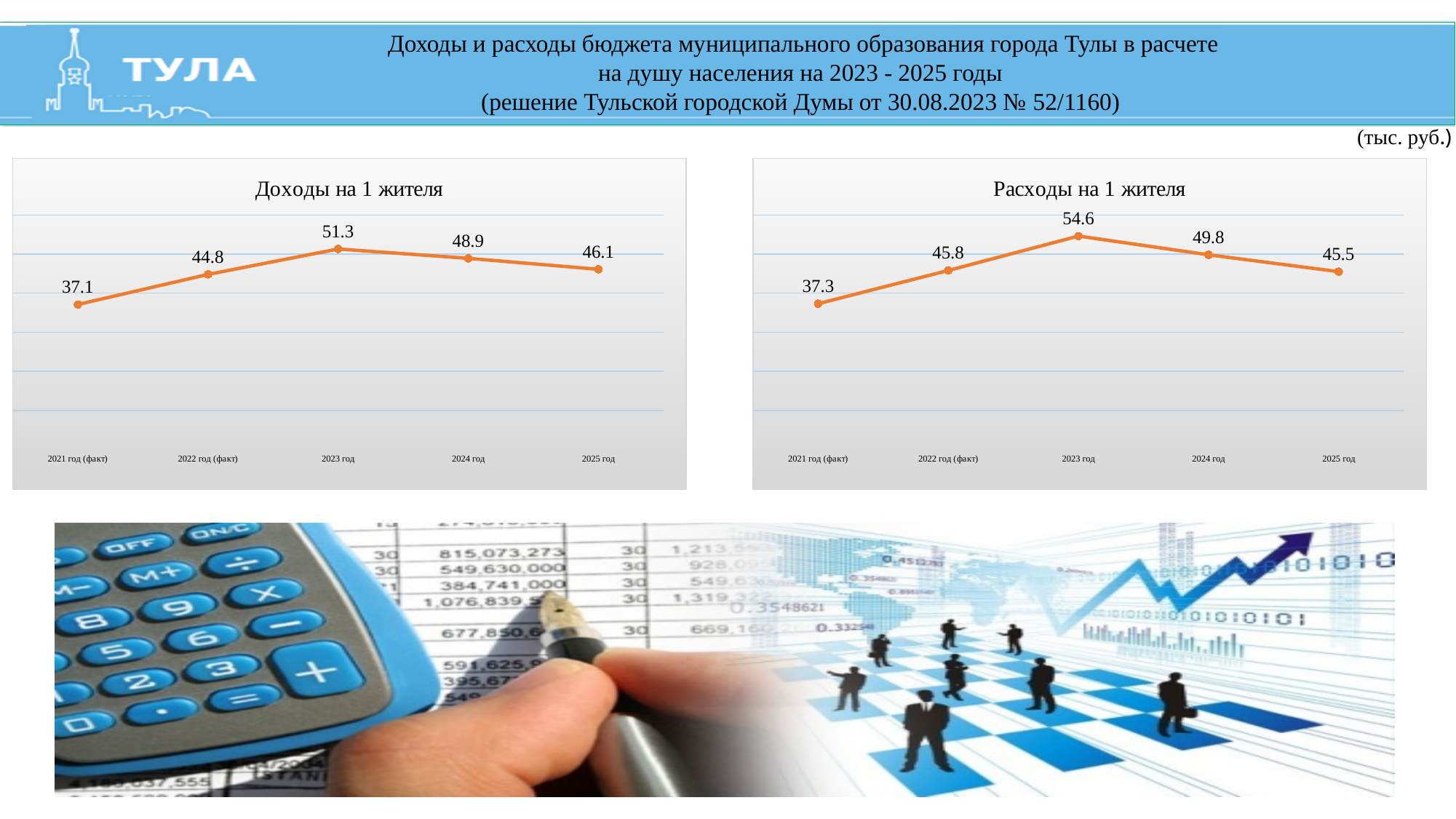
What kind of chart is the chart titled "Доходы на 1 жителя"? Line chart In the chart titled "Доходы на 1 жителя", which year has the highest value? 2023 год In the chart titled "Доходы на 1 жителя", what is the value for 2023 год? 51.3 In the chart titled "Расходы на 1 жителя", what is the value for 2021 год (факт)? 37.3 In the chart titled "Доходы на 1 жителя", which is larger: the value for 2024 год or the value for 2025 год? 2024 год In the chart titled "Расходы на 1 жителя", do the values rise or fall from 2023 год to 2025 год? Fall In the chart titled "Доходы на 1 жителя", do the values rise or fall from 2021 год (факт) to 2023 год? Rise How many data points are plotted in the chart titled "Расходы на 1 жителя"? 5 In the chart titled "Доходы на 1 жителя", what is the difference between the values for 2022 год (факт) and 2021 год (факт)? 7.7 In the chart titled "Расходы на 1 жителя", what is the difference between the values for 2023 год and 2025 год? 9.1 What is the title of the chart on the right side of the slide? Расходы на 1 жителя In the chart titled "Расходы на 1 жителя", which year has the lowest value? 2021 год (факт)